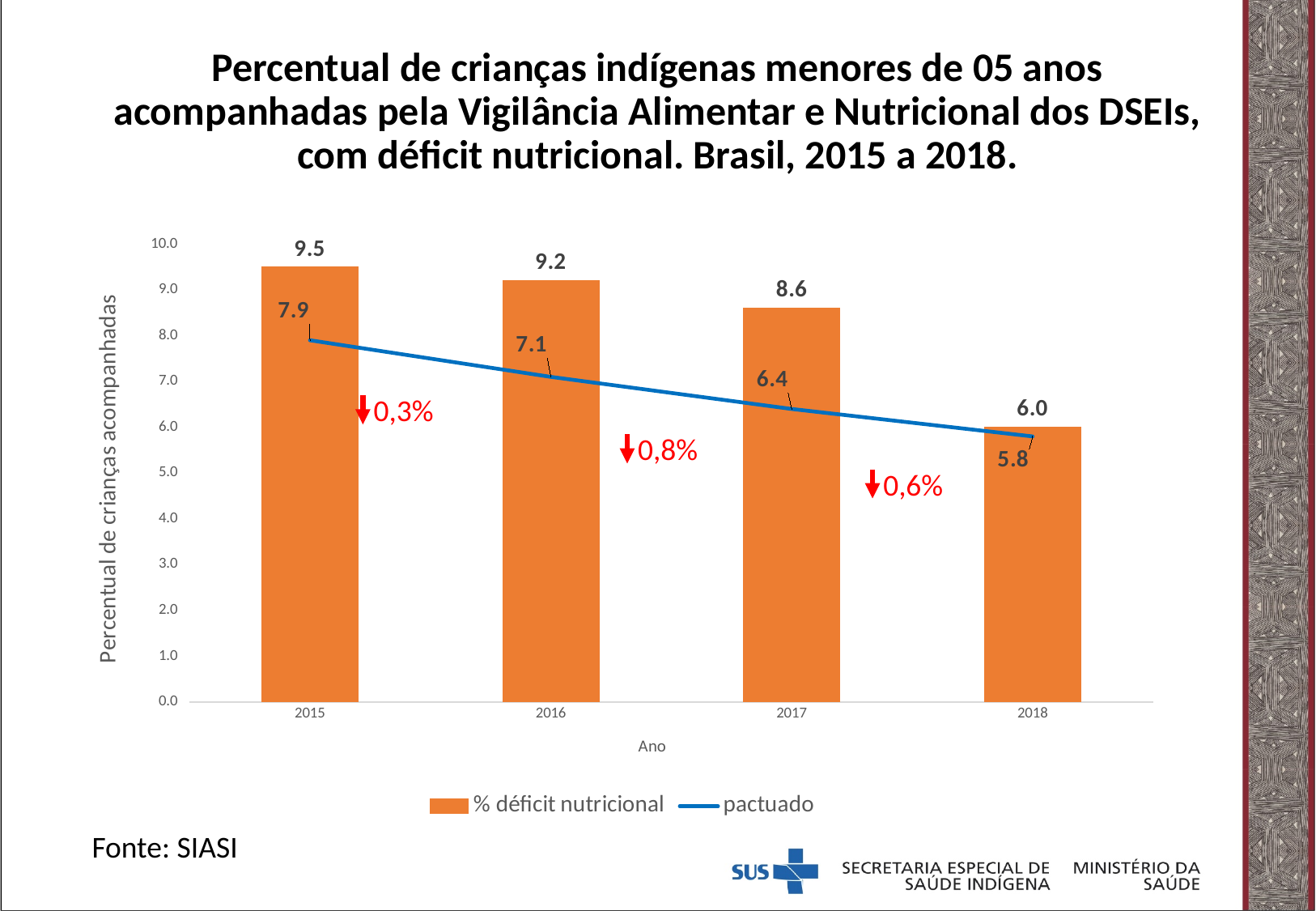
What is the value of "pactuado" for 2016? 7.1 Which year has the lowest value of "pactuado"? 2018 Does the "% déficit nutricional" series rise or fall from 2015 to 2018? fall Which year has the highest value of "% déficit nutricional"? 2015 What is the label of the y axis? Percentual de crianças acompanhadas How many series does the legend list? 2 What is the value of "% déficit nutricional" for 2018? 6.0 How many years are shown on the x axis? 4 What is the difference between the "% déficit nutricional" values for 2015 and 2018? 3.5 What is the value of "pactuado" for 2017? 6.4 What is the value of "% déficit nutricional" for 2015? 9.5 Which is larger in 2017: "% déficit nutricional" or "pactuado"? % déficit nutricional